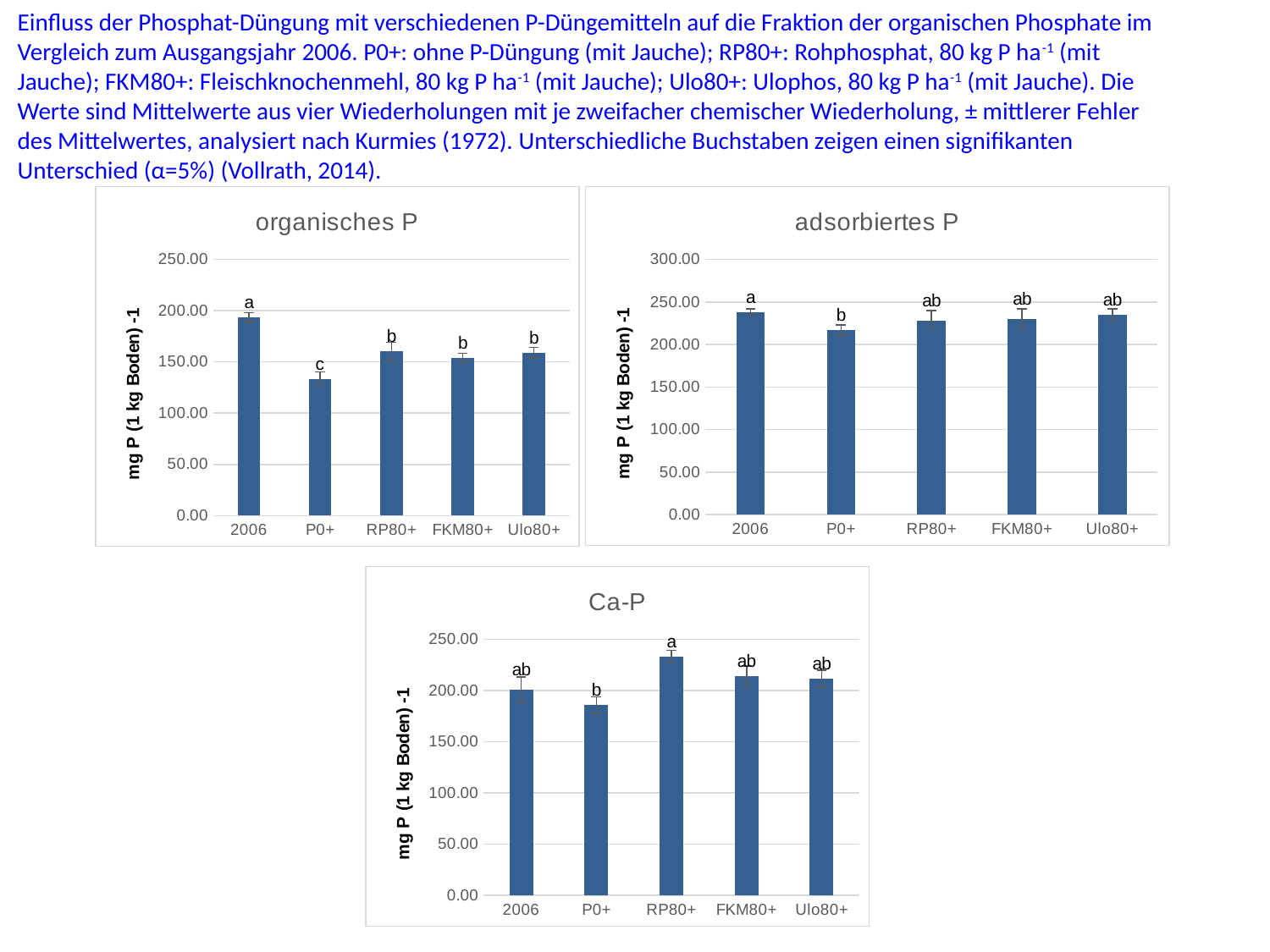
In the 'adsorbiertes P' chart, which is larger, the value for 2006 or the value for P0+? 2006 How many categories are shown on the x axis of the 'Ca-P' chart? 5 In the 'adsorbiertes P' chart, is the value for P0+ greater or less than 200.00? greater In the 'organisches P' chart, which category has the highest bar? 2006 What kind of chart is the 'organisches P' chart? bar chart In the 'organisches P' chart, which category has the lowest bar? P0+ In the 'Ca-P' chart, which category has the highest bar? RP80+ In the 'organisches P' chart, is the value for 2006 greater or less than 150.00? greater In the 'Ca-P' chart, which category has the lowest bar? P0+ In the 'adsorbiertes P' chart, is the value for 2006 greater or less than 250.00? less